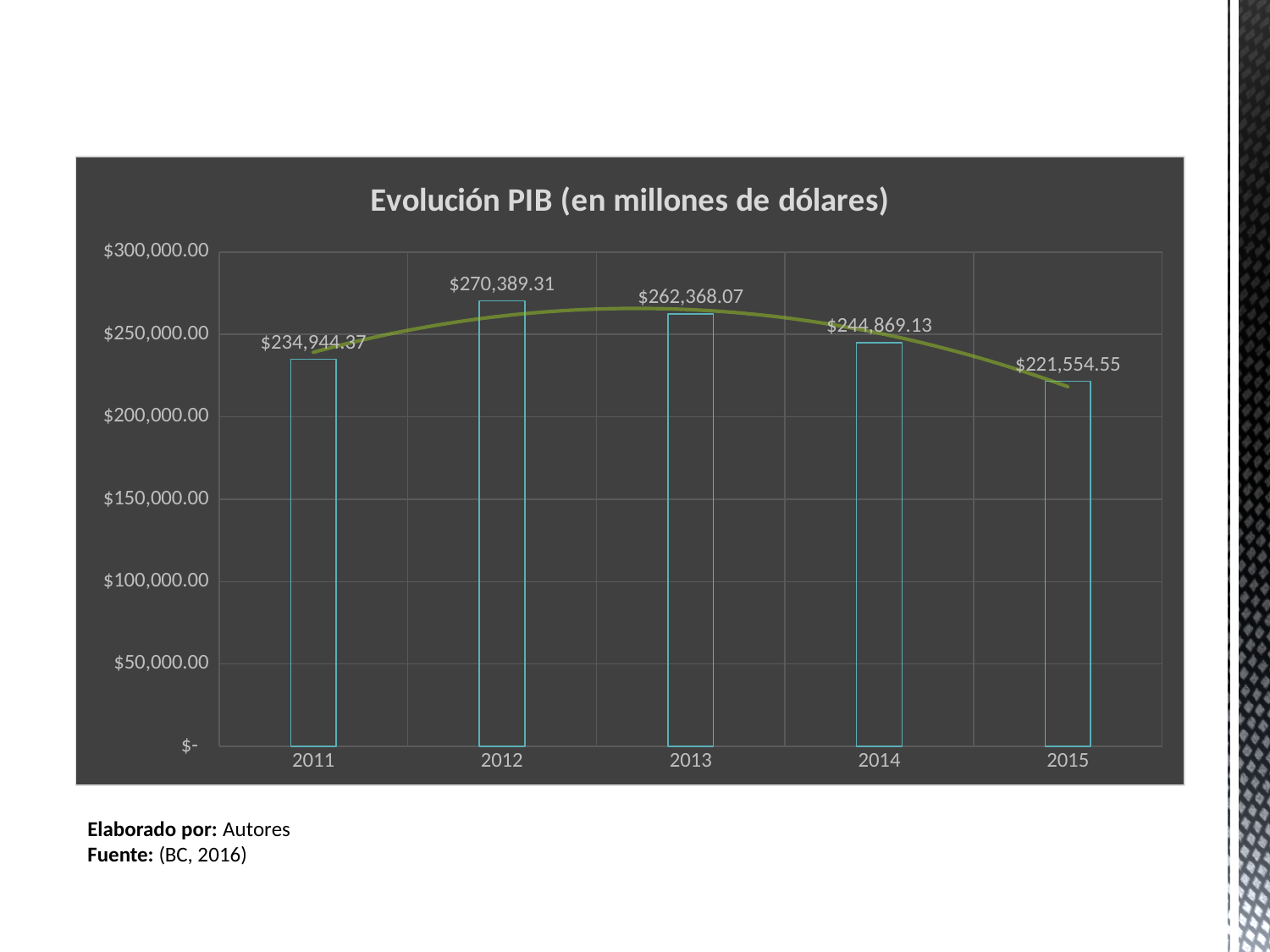
What is the value for 2013? $262,368.07 Which is larger, the value for 2013 or the value for 2014? 2013 Is the value for 2014 greater or less than $250,000.00? less What is the difference between the values for 2013 and 2014? $17,498.94 Do the values rise or fall from 2012 to 2015? fall What is the difference between the values for 2012 and 2011? $35,444.94 What kind of chart is this? bar chart What is the value for 2011? $234,944.37 Which year has the lowest value? 2015 How many years are shown on the x axis? 5 What is the value for 2015? $221,554.55 Which year has the highest value? 2012